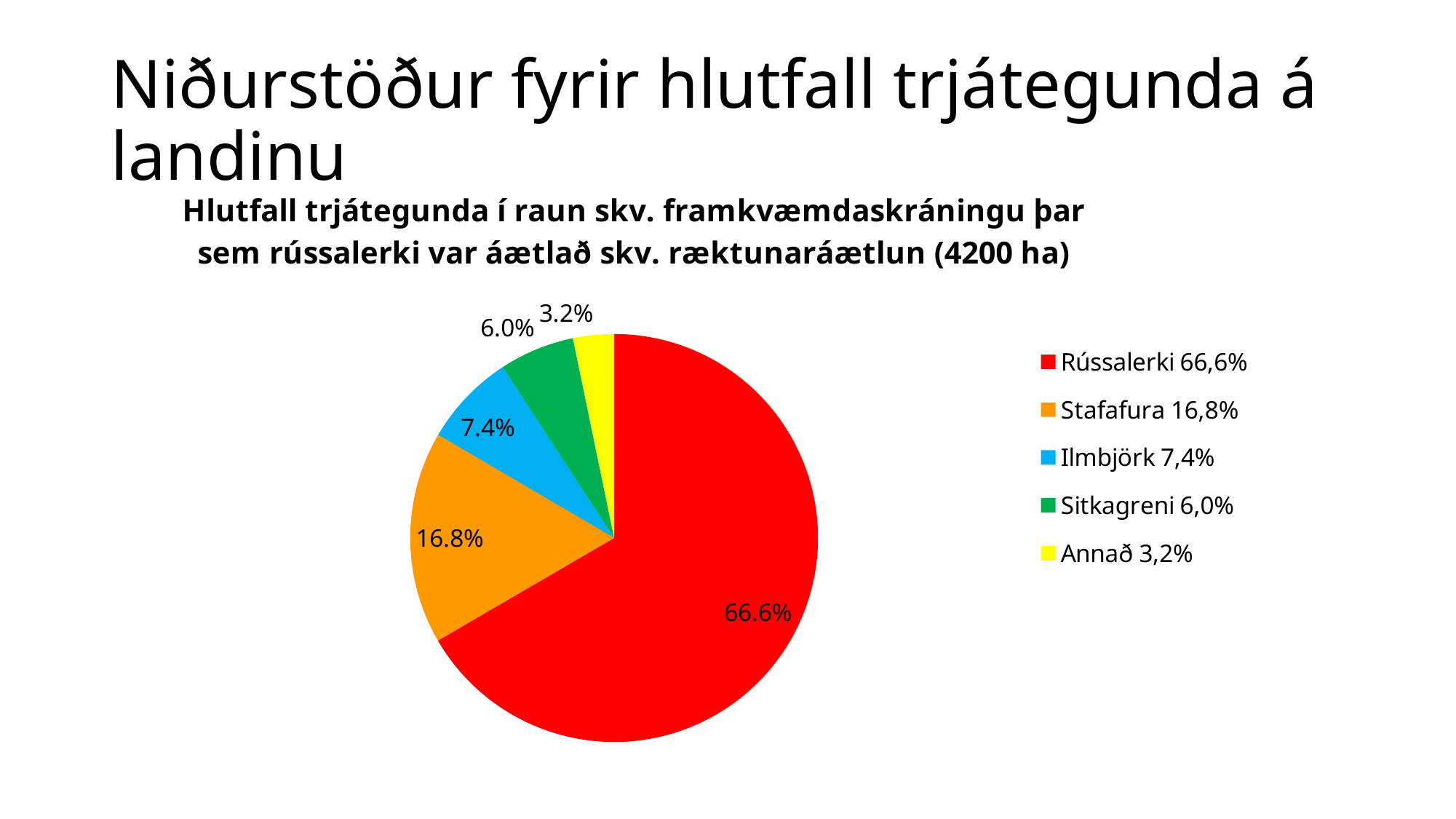
How many categories does the pie chart show? 5 What share of the pie does Stafafura have? 16.8% What colour is the Sitkagreni slice in the pie chart? green What share of the pie does Ilmbjörk have? 7.4% Which category has the largest slice of the pie? Rússalerki Which slice is larger, Ilmbjörk or Sitkagreni? Ilmbjörk What is the difference in percentage points between the Rússalerki and Stafafura slices? 49.8 What kind of chart is shown on the slide? pie chart What share of the pie does Annað have? 3.2% Which category has the smallest slice of the pie? Annað